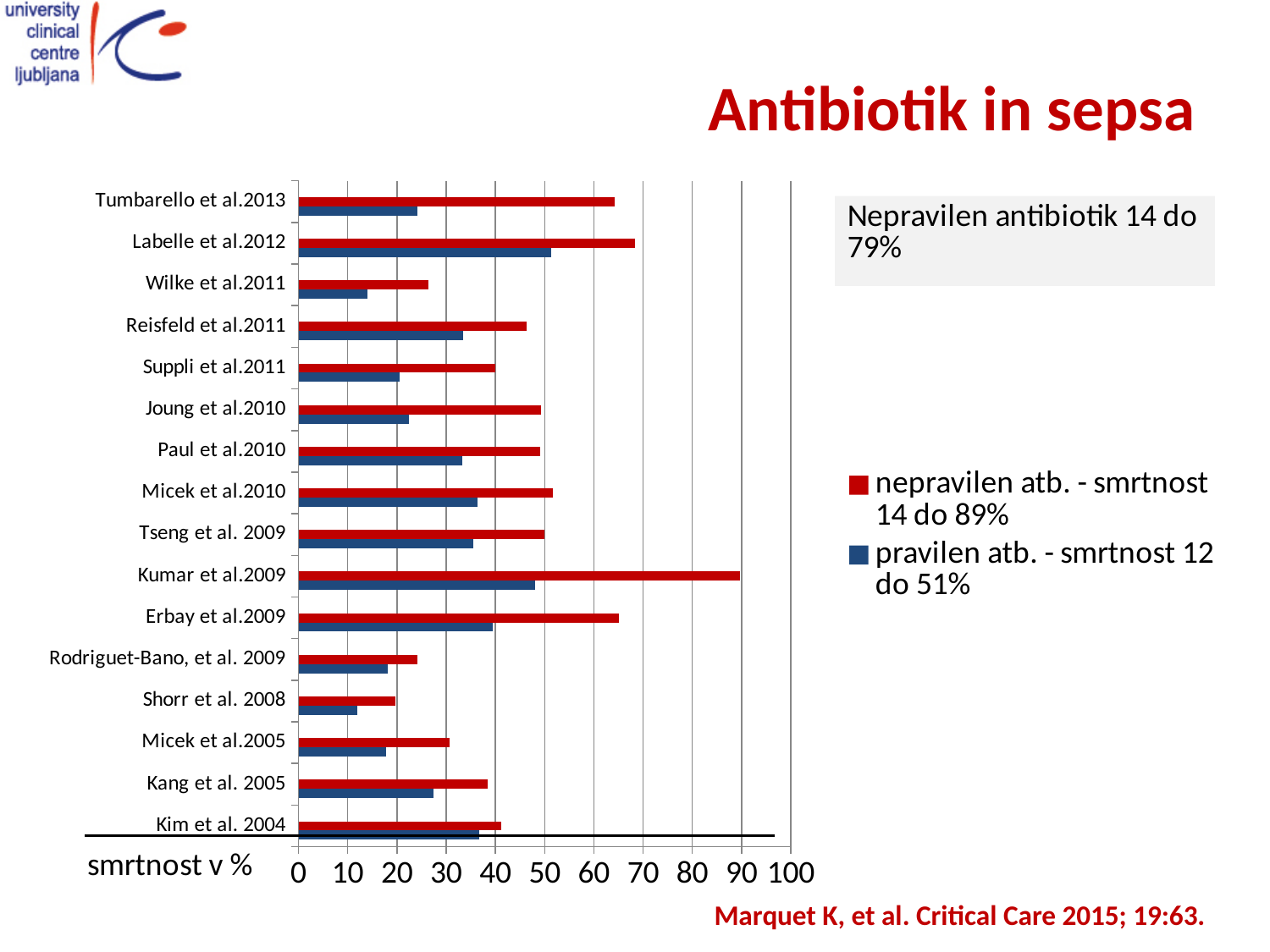
Is the 'nepravilen atb.' value for Kumar et al.2009 greater or less than 80? greater Which is larger: the 'pravilen atb.' value for Labelle et al.2012 or for Wilke et al.2011? Labelle et al.2012 What is the label shown for the horizontal axis of the chart? smrtnost v % Is the 'nepravilen atb.' value for Labelle et al.2012 greater or less than 60? greater Is the 'pravilen atb.' value for Shorr et al. 2008 greater or less than 20? less Which study has the lowest value for the 'nepravilen atb. - smrtnost 14 do 89%' series? Shorr et al. 2008 Which is larger: the 'nepravilen atb.' value for Kumar et al.2009 or for Labelle et al.2012? Kumar et al.2009 How many studies (categories) are listed on the chart? 16 What kind of chart is shown on the slide? bar chart How many series does the chart legend list? 2 Which study has the highest value for the 'nepravilen atb. - smrtnost 14 do 89%' series? Kumar et al.2009